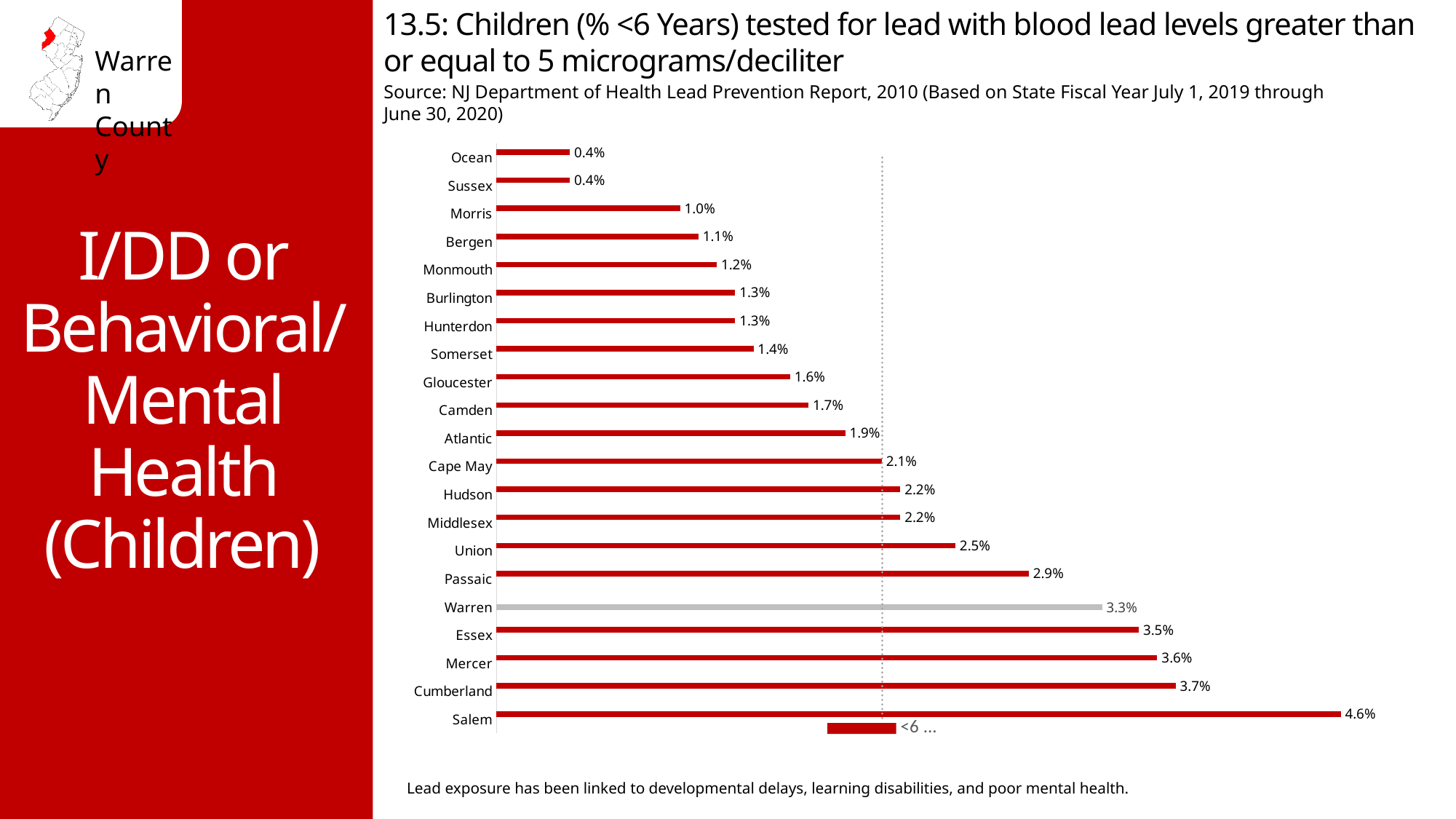
Which has a larger value, Camden or Atlantic? Atlantic Which county has the highest value? Salem What is the value for Morris? 1.0% What is the value for Warren County? 3.3% Which has a larger value, Essex or Union? Essex Which county's bar is shown in gray rather than red? Warren What is the difference between the values for Cumberland and Passaic? 0.8% Which counties share the lowest value? Ocean and Sussex What is the difference between the values for Salem and Warren? 1.3% How many counties are shown in the chart? 21 What kind of chart is shown? Bar chart What is the value for Salem? 4.6%